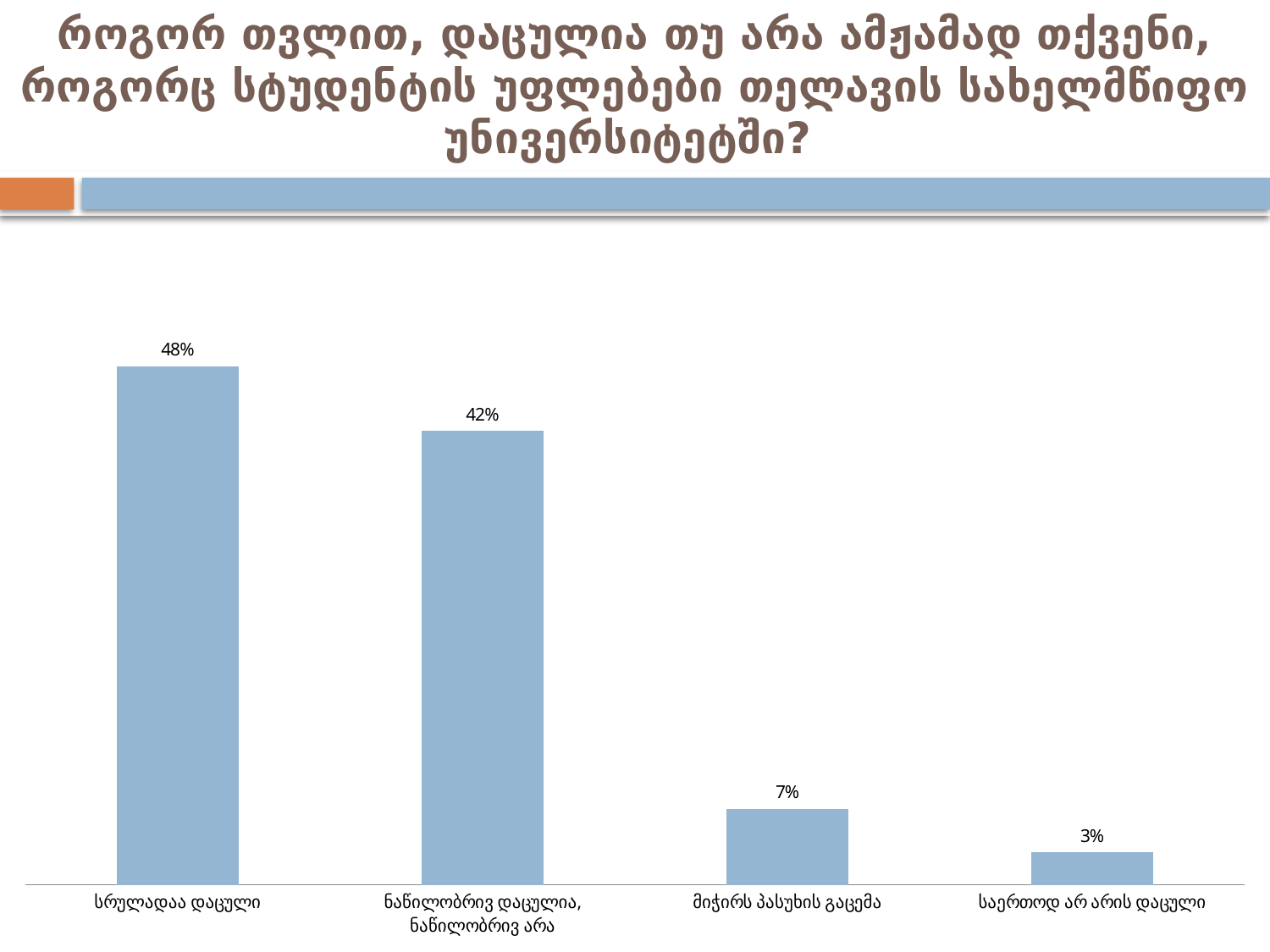
What is the value for "საერთოდ არ არის დაცული"? 3% What kind of chart is shown on the slide? Bar chart Which category has the highest value? სრულადაა დაცული Which category has the lowest value? საერთოდ არ არის დაცული What colour are the bars in the chart? Light blue What is the value for "მიჭირს პასუხის გაცემა"? 7% What is the value for "ნაწილობრივ დაცულია, ნაწილობრივ არა"? 42% What is the value for "სრულადაა დაცული"? 48% How many categories are shown in the chart? 4 Which is larger, the value for "მიჭირს პასუხის გაცემა" or the value for "საერთოდ არ არის დაცული"? მიჭირს პასუხის გაცემა What is the difference between the values for "მიჭირს პასუხის გაცემა" and "საერთოდ არ არის დაცული"? 4% What is the difference between the values for "სრულადაა დაცული" and "ნაწილობრივ დაცულია, ნაწილობრივ არა"? 6%